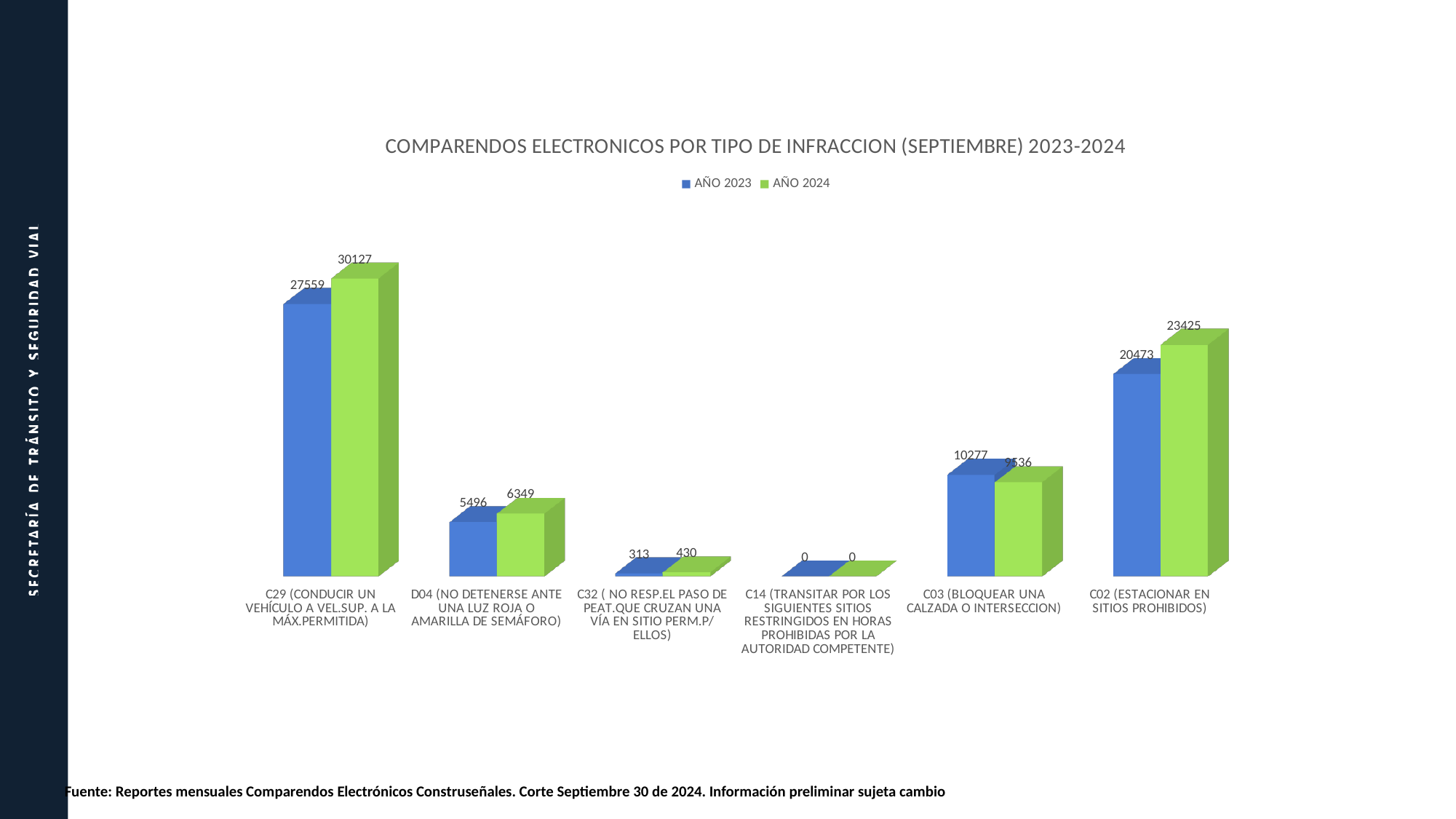
Which category has the highest value for AÑO 2023? C29 (CONDUCIR UN VEHÍCULO A VEL.SUP. A LA MÁX.PERMITIDA) What is the difference between the AÑO 2023 and AÑO 2024 values for C03 (BLOQUEAR UNA CALZADA O INTERSECCION)? 741 How many series does the legend list? 2 What is the value for AÑO 2023 for C02 (ESTACIONAR EN SITIOS PROHIBIDOS)? 20473 What is the difference between the AÑO 2024 and AÑO 2023 values for C02 (ESTACIONAR EN SITIOS PROHIBIDOS)? 2952 What is the value for AÑO 2024 for C03 (BLOQUEAR UNA CALZADA O INTERSECCION)? 9536 For C03 (BLOQUEAR UNA CALZADA O INTERSECCION), which series has the larger value, AÑO 2023 or AÑO 2024? AÑO 2023 Which category has the lowest value for AÑO 2024? C14 (TRANSITAR POR LOS SIGUIENTES SITIOS RESTRINGIDOS EN HORAS PROHIBIDAS POR LA AUTORIDAD COMPETENTE) What is the value for AÑO 2024 for C29 (CONDUCIR UN VEHÍCULO A VEL.SUP. A LA MÁX.PERMITIDA)? 30127 How many infraction categories are shown on the x axis? 6 For D04 (NO DETENERSE ANTE UNA LUZ ROJA O AMARILLA DE SEMÁFORO), which series has the larger value, AÑO 2023 or AÑO 2024? AÑO 2024 What kind of chart is shown on the slide? Bar chart